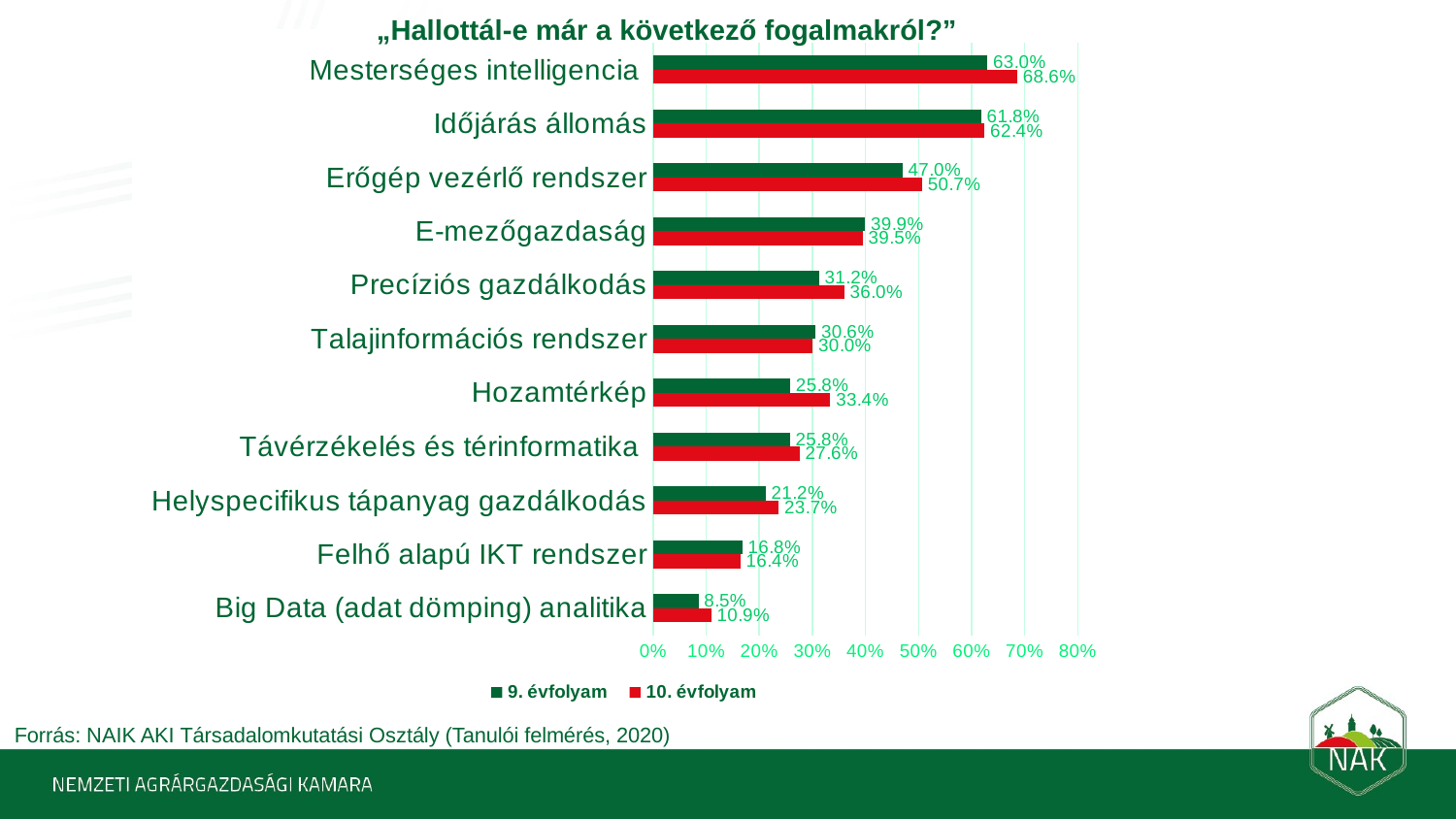
For Precíziós gazdálkodás, which series has the larger value, 9. évfolyam or 10. évfolyam? 10. évfolyam What is the title of the chart? „Hallottál-e már a következő fogalmakról?” How many categories are shown on the chart? 11 Which category has the highest value for 10. évfolyam? Mesterséges intelligencia What is the value for 9. évfolyam for Mesterséges intelligencia? 63.0% What is the difference between the 10. évfolyam and 9. évfolyam values for Mesterséges intelligencia? 5.6% What is the value for 10. évfolyam for Big Data (adat dömping) analitika? 10.9% What is the value for 10. évfolyam for Hozamtérkép? 33.4% Which category has the lowest value for 9. évfolyam? Big Data (adat dömping) analitika What kind of chart is shown on the slide? bar chart Is the 9. évfolyam value for Erőgép vezérlő rendszer greater or less than 50%? less How many series does the legend list? 2